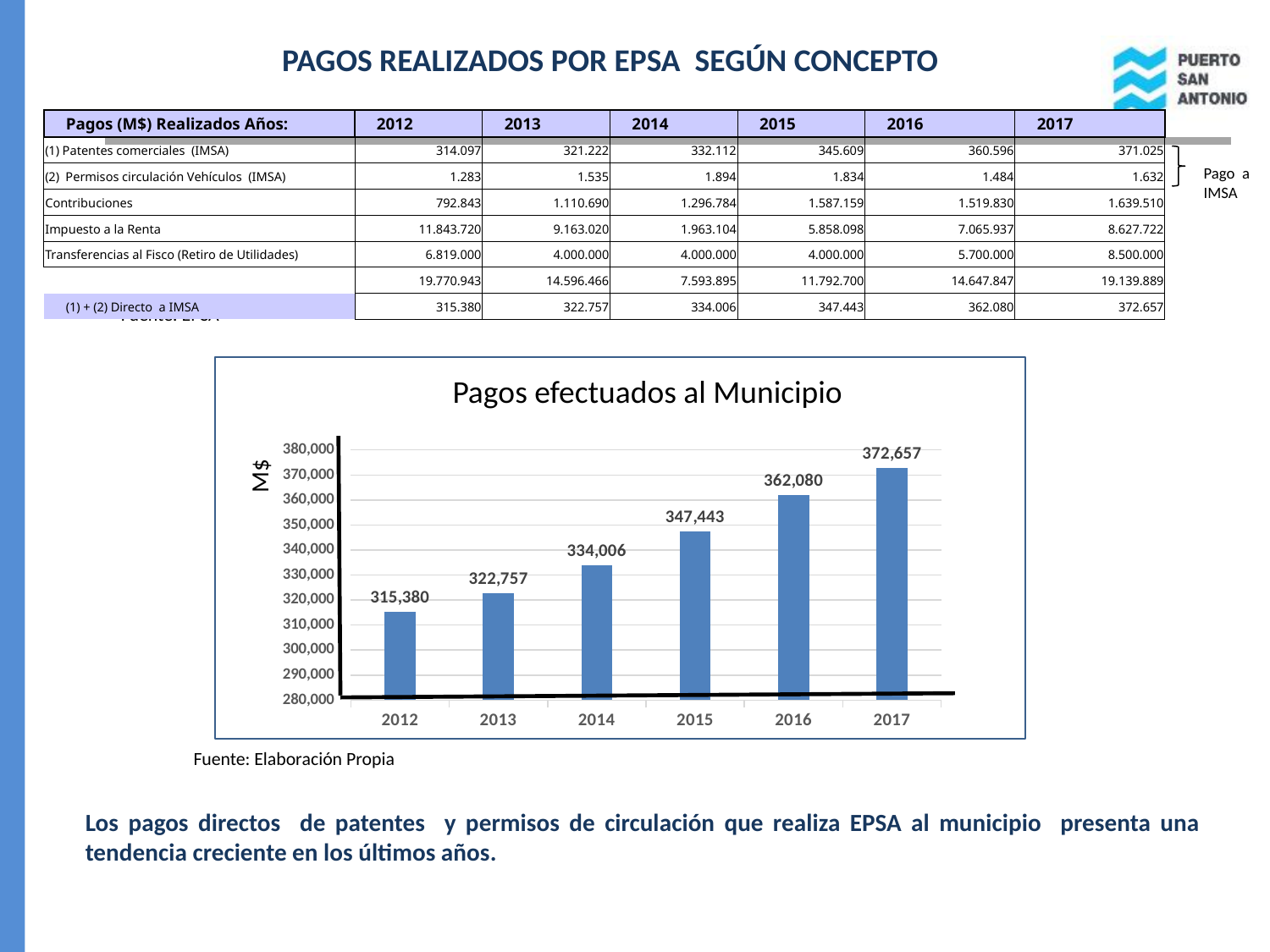
What is the value for 2017 in the 'Pagos efectuados al Municipio' chart? 372,657 What is the difference between the 2016 and 2015 values in the 'Pagos efectuados al Municipio' chart? 14,637 Is the value for 2016 in the 'Pagos efectuados al Municipio' chart greater or less than 350,000? greater In the 'Pagos efectuados al Municipio' chart, which is larger, the value for 2014 or the value for 2013? 2014 Which year has the lowest value in the 'Pagos efectuados al Municipio' chart? 2012 What is the value for 2015 in the 'Pagos efectuados al Municipio' chart? 347,443 How many years are shown on the x axis of the 'Pagos efectuados al Municipio' chart? 6 Do the values in the 'Pagos efectuados al Municipio' chart rise or fall from 2012 to 2017? rise What is the difference between the 2017 and 2012 values in the 'Pagos efectuados al Municipio' chart? 57,277 What type of chart is 'Pagos efectuados al Municipio'? bar chart Which year has the highest value in the 'Pagos efectuados al Municipio' chart? 2017 What is the value for 2012 in the 'Pagos efectuados al Municipio' chart? 315,380